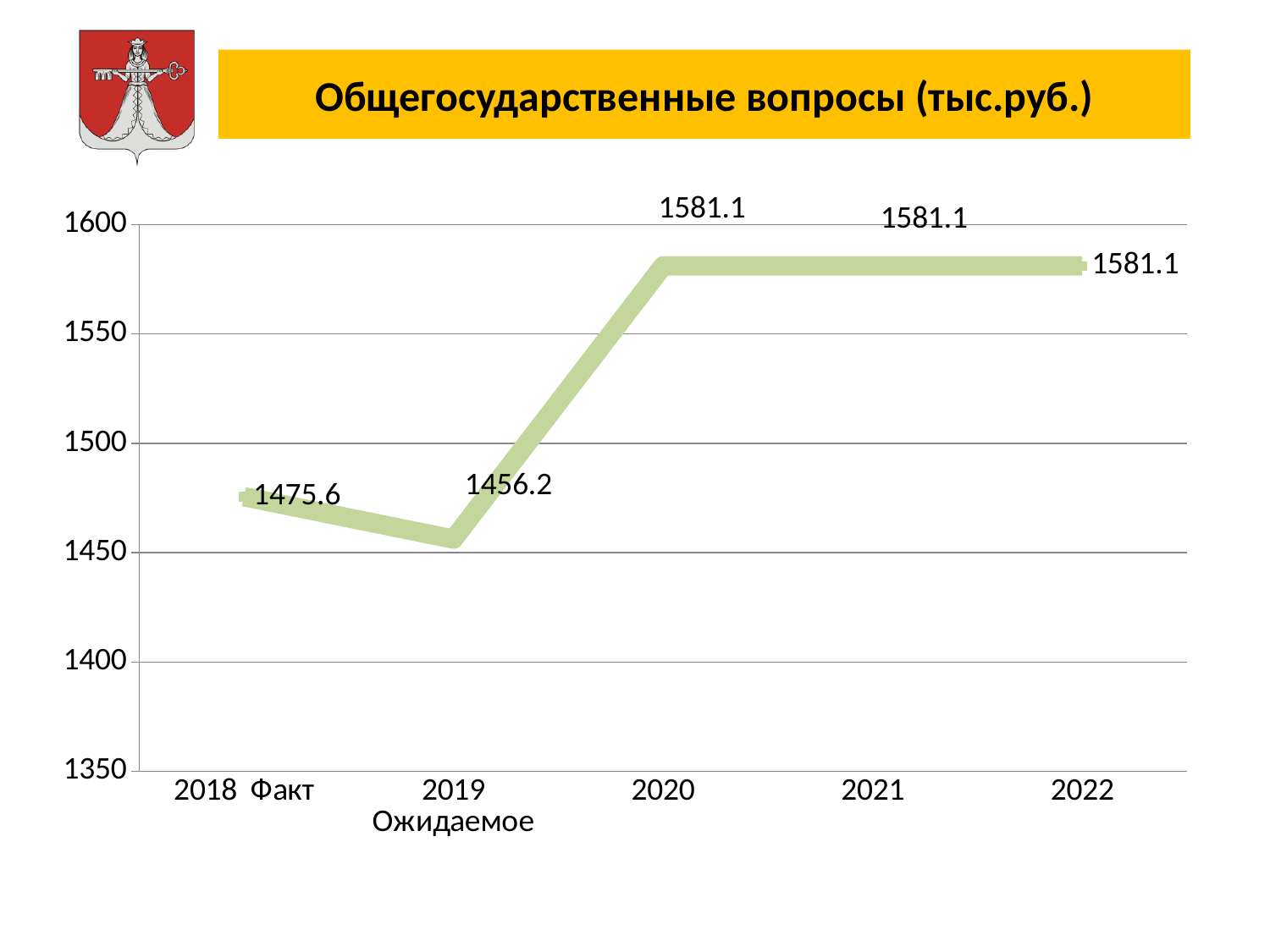
What is the value for 2020? 1581.1 What is the title of the chart? Общегосударственные вопросы (тыс.руб.) Which is larger, the value for 2018 Факт or the value for 2021? 2021 What is the difference between the values for 2020 and 2019 Ожидаемое? 124.9 What kind of chart is this? line chart What is the value for 2022? 1581.1 What is the value for 2018 Факт? 1475.6 How many categories are shown on the x axis? 5 Which category has the lowest value? 2019 Ожидаемое Is the value for 2019 Ожидаемое greater or less than 1500? less What is the value for 2019 Ожидаемое? 1456.2 What is the difference between the values for 2018 Факт and 2019 Ожидаемое? 19.4